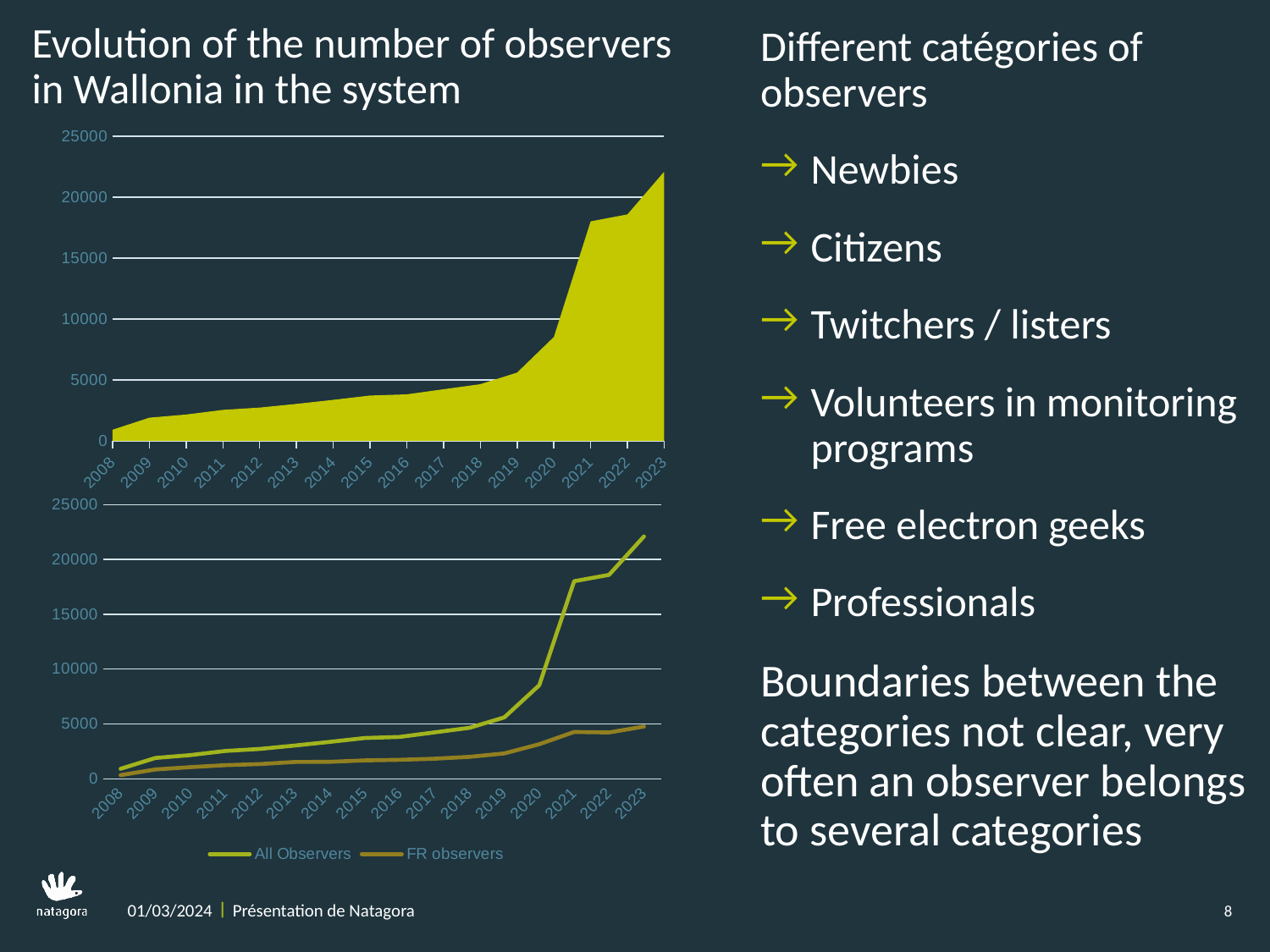
In the bottom chart, is the value for All Observers in 2021 greater or less than 15000? greater In the top chart, is the value for 2020 greater or less than 10000? less What are the two series named in the legend of the bottom chart? All Observers and FR observers In the top chart, do the values generally rise or fall from 2008 to 2023? rise In the top chart, which year has the lowest number of observers? 2008 In the top chart, is the value for 2023 greater or less than 20000? greater In the top chart, which year has the highest number of observers? 2023 How many years are shown on the x axis of the top chart? 16 In the bottom chart, which series has the larger value in 2023, All Observers or FR observers? All Observers What kind of chart is the top chart on the slide? area chart What kind of chart is the bottom chart on the slide? line chart How many series does the legend of the bottom chart list? 2